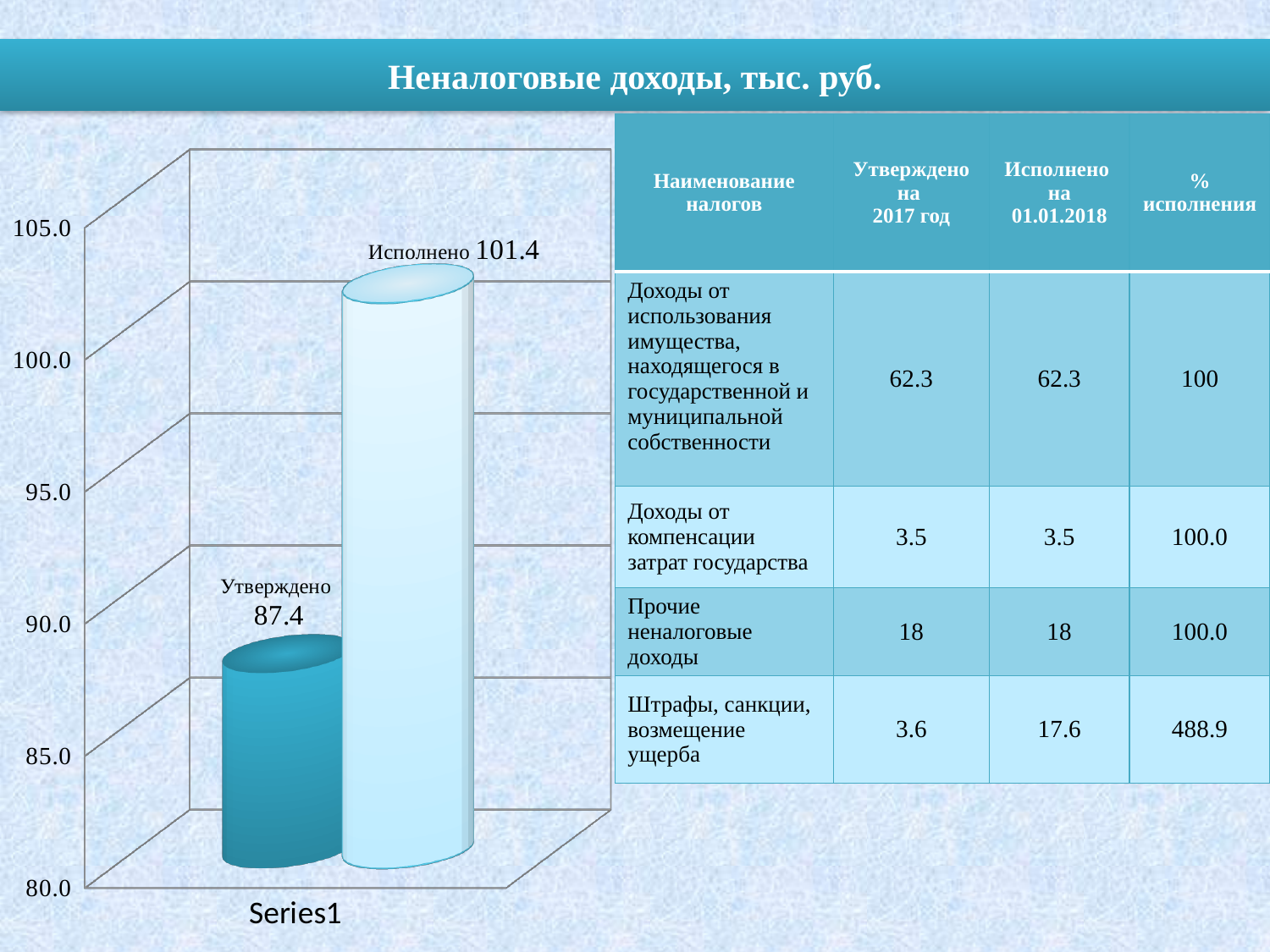
What is the category label shown under the bars on the x axis? Series1 What kind of chart is shown on the slide? bar chart What is the difference between the "Исполнено" value and the "Утверждено" value? 14.0 What is the title of the slide above the chart? Неналоговые доходы, тыс. руб. Is the value for "Исполнено" greater or less than 100.0? greater Which bar has the lowest value on the chart? Утверждено What is the value of the bar labelled "Исполнено"? 101.4 Which bar is taller, "Утверждено" or "Исполнено"? Исполнено What is the value of the bar labelled "Утверждено"? 87.4 Which bar has the highest value on the chart? Исполнено Is the value for "Утверждено" greater or less than 90.0? less How many bars are plotted on the chart? 2